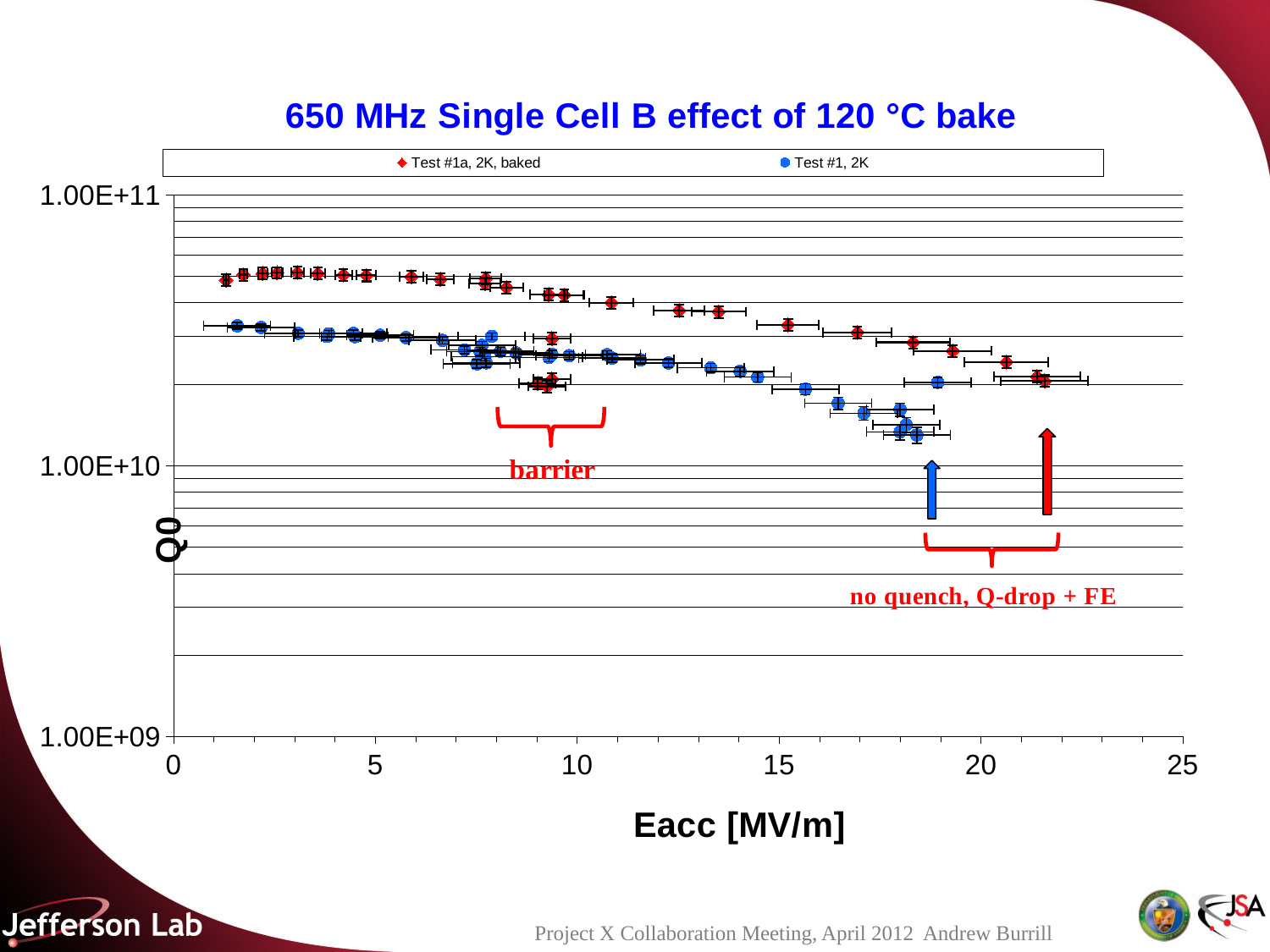
Do the Q0 values for the Test #1, 2K series rise or fall as Eacc increases? Fall Do the Q0 values for the Test #1a, 2K, baked series rise or fall as Eacc increases? Fall Is the Q0 value for the Test #1a, 2K, baked series at an Eacc of about 20 MV/m greater or less than 1.00E+10? greater Is the Q0 value for the Test #1, 2K series at an Eacc of about 5 MV/m greater or less than 1.00E+10? greater What is the title of the chart? 650 MHz Single Cell B effect of 120 °C bake Which series has the higher Q0 values at an Eacc of about 15 MV/m, Test #1a, 2K, baked or Test #1, 2K? Test #1a, 2K, baked What is the lowest value shown on the y axis? 1.00E+09 Is the highest Q0 value for the Test #1a, 2K, baked series greater or less than 1.00E+11? less How many series does the chart legend list? 2 Which series reaches the higher maximum Eacc, Test #1a, 2K, baked or Test #1, 2K? Test #1a, 2K, baked What kind of chart is shown on the slide? Scatter chart What is the label of the x axis? Eacc [MV/m]